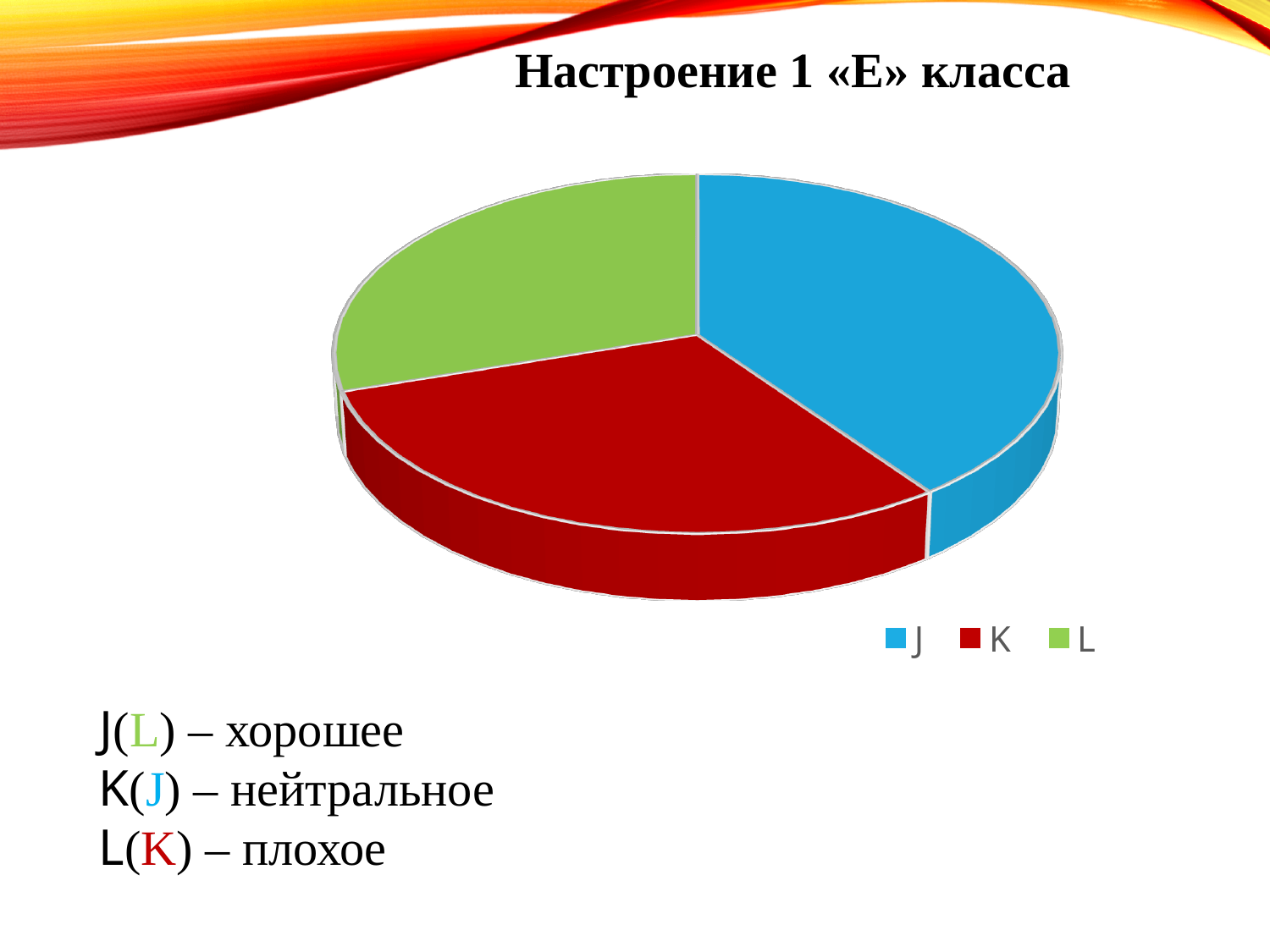
How many entries does the legend of the pie chart list? 3 What is the title of the chart on the slide? Настроение 1 «Е» класса Which slice is larger in the pie chart, J or L? J What kind of chart is shown on the slide? pie chart What colour is the slice for K in the pie chart? red How many slices does the pie chart have? 3